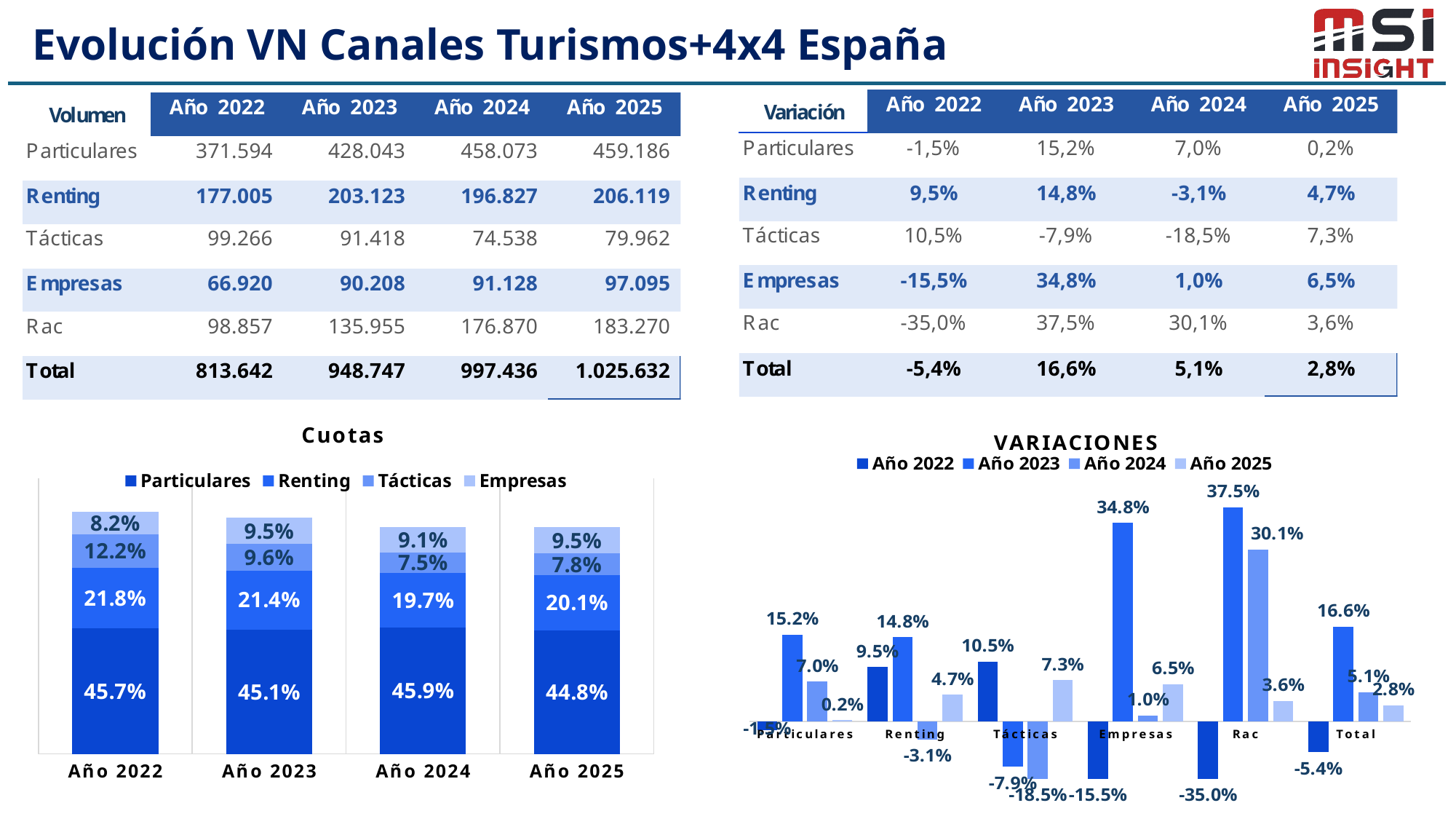
In the "Cuotas" chart, what is the share for Tácticas in Año 2022? 12.2% In the "Cuotas" chart, what is the difference between the Renting share in Año 2022 and in Año 2025? 1.7 percentage points In the "VARIACIONES" chart, which is larger: Empresas in Año 2023 or Rac in Año 2024? Empresas in Año 2023 In the "VARIACIONES" chart, what is the value for Total in Año 2025? 2.8% In the "VARIACIONES" chart, which category and year has the highest value? Rac, Año 2023 How many categories are shown on the x axis of the "VARIACIONES" chart? 6 In the "VARIACIONES" chart, which category and year has the lowest value? Rac, Año 2022 In the "VARIACIONES" chart, what is the value for Rac in Año 2023? 37.5% In the "Cuotas" chart, what is the share for Particulares in Año 2024? 45.9% In the "Cuotas" chart, in which year is the Particulares share the lowest? Año 2025 How many series does the legend of the "Cuotas" chart list? 4 What kind of chart is the "Cuotas" chart on the left? Stacked bar chart